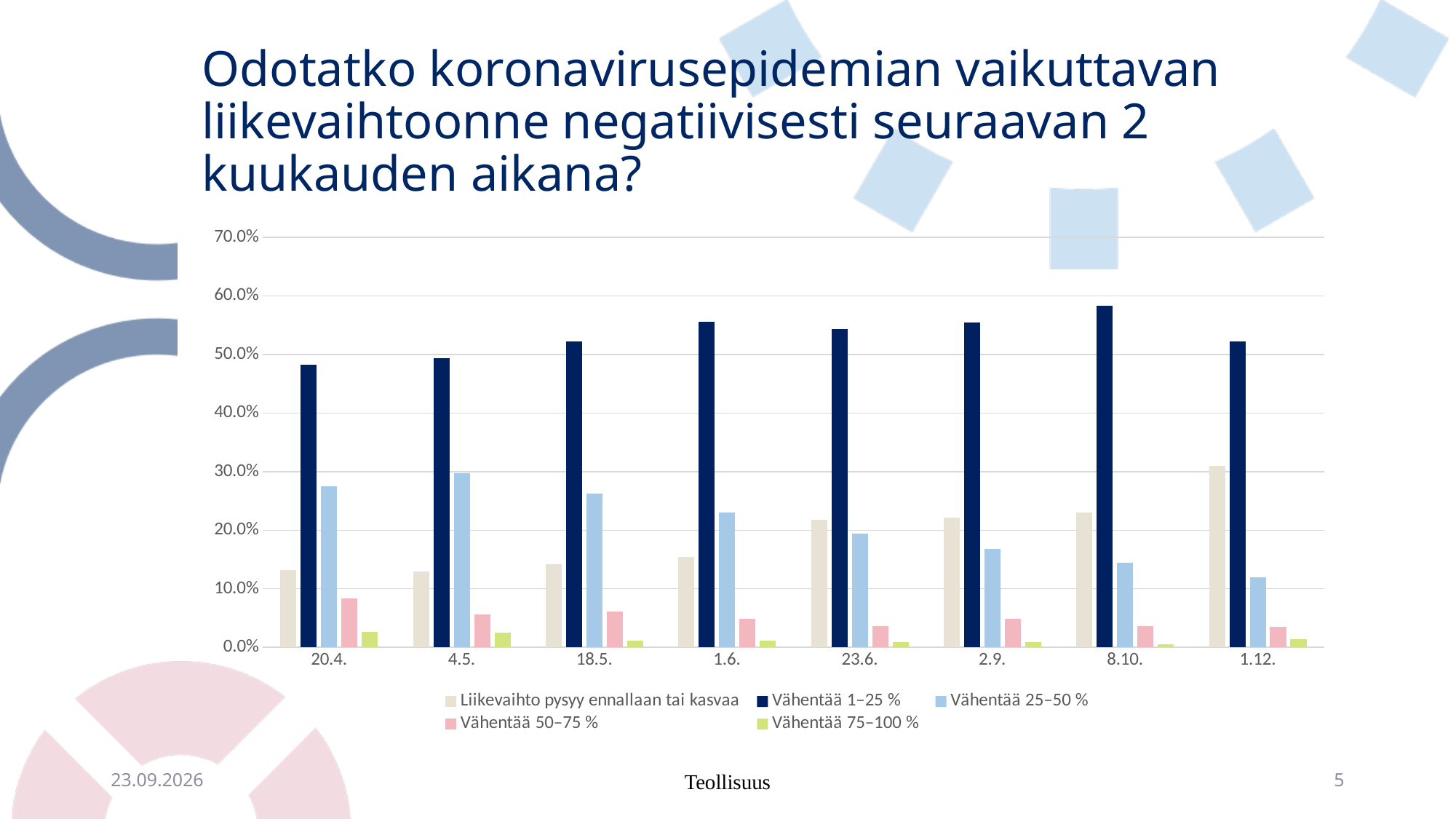
On which date is the value for 'Vähentää 1–25 %' lowest? 20.4. Is the value for 'Vähentää 1–25 %' on 8.10. greater or less than 50.0%? greater On 20.4., which is larger: 'Vähentää 1–25 %' or 'Vähentää 25–50 %'? Vähentää 1–25 % On which date is the value for 'Vähentää 25–50 %' highest? 4.5. Is the value for 'Vähentää 25–50 %' on 1.12. greater or less than 20.0%? less Which series is shown in dark blue in the legend? Vähentää 1–25 % On which date is the value for 'Liikevaihto pysyy ennallaan tai kasvaa' highest? 1.12. What kind of chart is shown on the slide? Bar chart Between 4.5. and 1.12., does the value for 'Vähentää 25–50 %' rise or fall? Fall How many dates (categories) are shown on the x axis? 8 On which date is the value for 'Vähentää 1–25 %' highest? 8.10. How many series does the legend list? 5